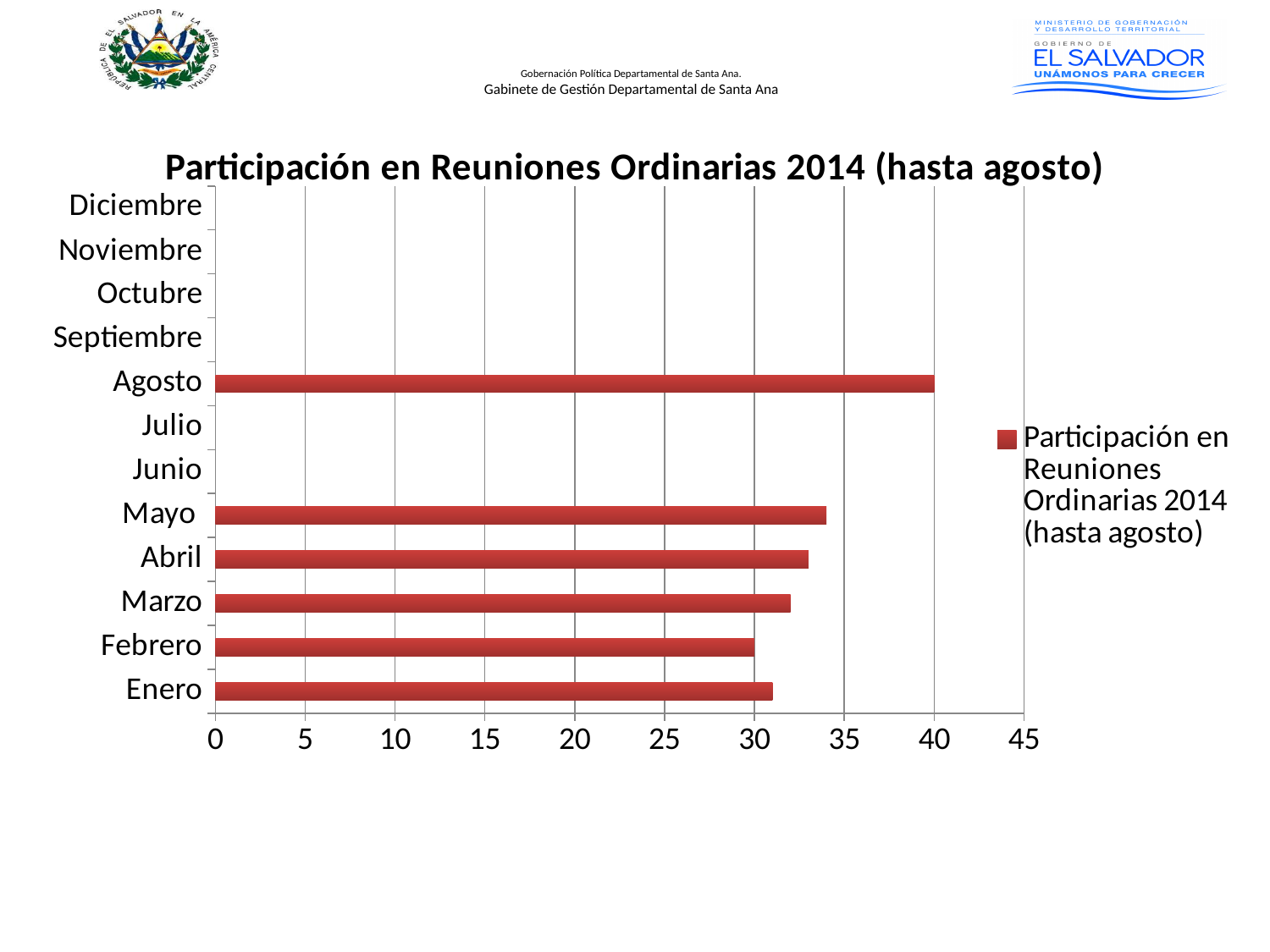
What is the value for Febrero? 30 How many month categories are listed on the vertical axis? 12 What is the title of the chart? Participación en Reuniones Ordinarias 2014 (hasta agosto) What is the value for Agosto? 40 What is the difference between the values for Agosto and Febrero? 10 Is the value for Marzo greater or less than 35? less How many months have a bar plotted in the chart? 6 What type of chart is shown on the slide? bar chart Is the value for Mayo greater or less than 30? greater How many series does the legend list? 1 Which is larger, the value for Agosto or the value for Mayo? Agosto Which month has the highest value? Agosto